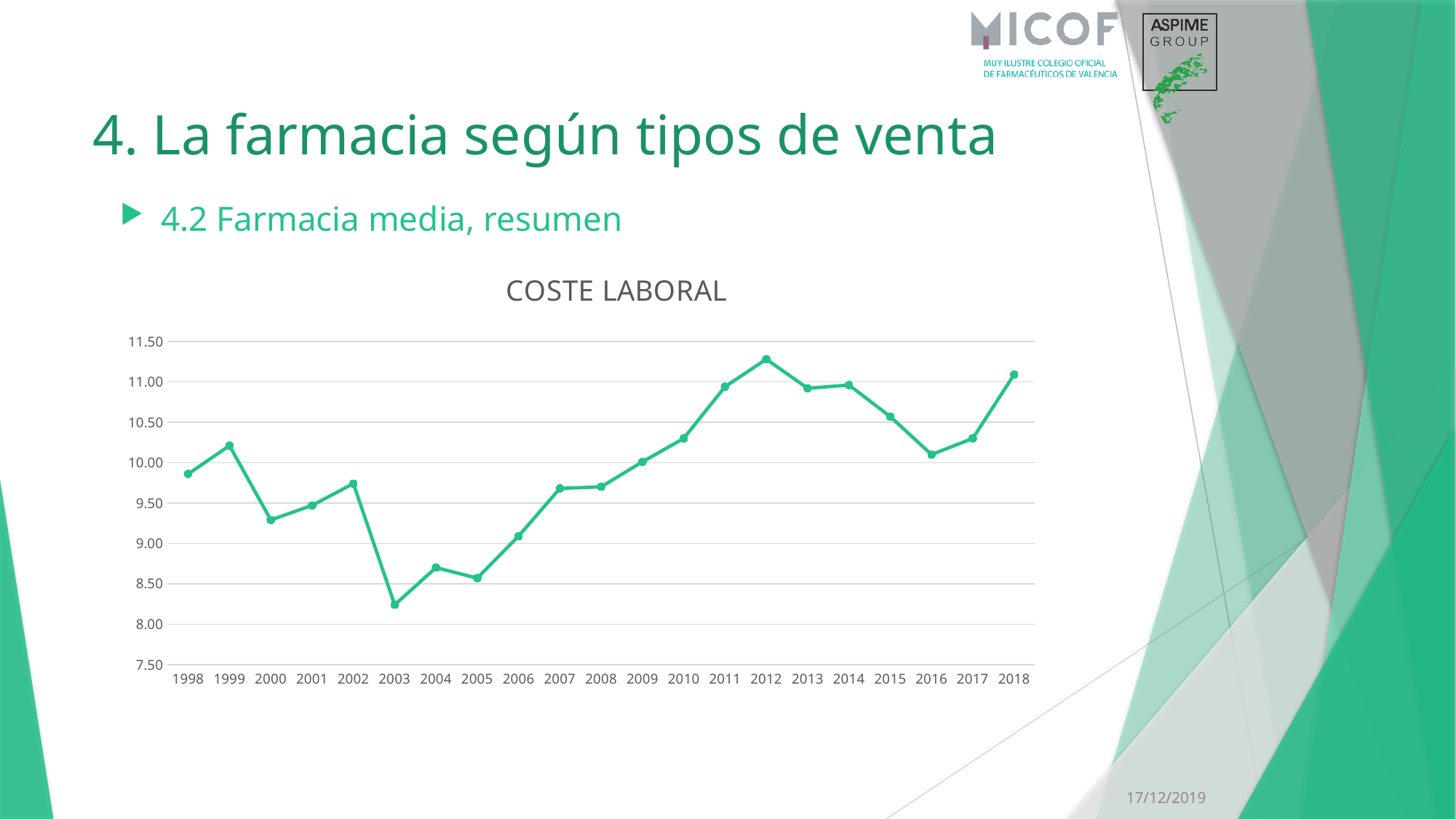
What kind of chart is shown on the slide? line chart Is the value for 2003 greater or less than 8.50? less Is the value for 2010 greater or less than 10.50? less How many years are plotted on the x axis of the chart? 21 Do the values rise or fall from 2003 to 2012? rise Is the value for 2002 greater or less than 9.50? greater Which year has the lowest value in the COSTE LABORAL chart? 2003 Which year has the larger value, 2017 or 2018? 2018 Which year has the highest value in the COSTE LABORAL chart? 2012 What is the title of the chart? COSTE LABORAL Which year has the larger value, 1999 or 2000? 1999